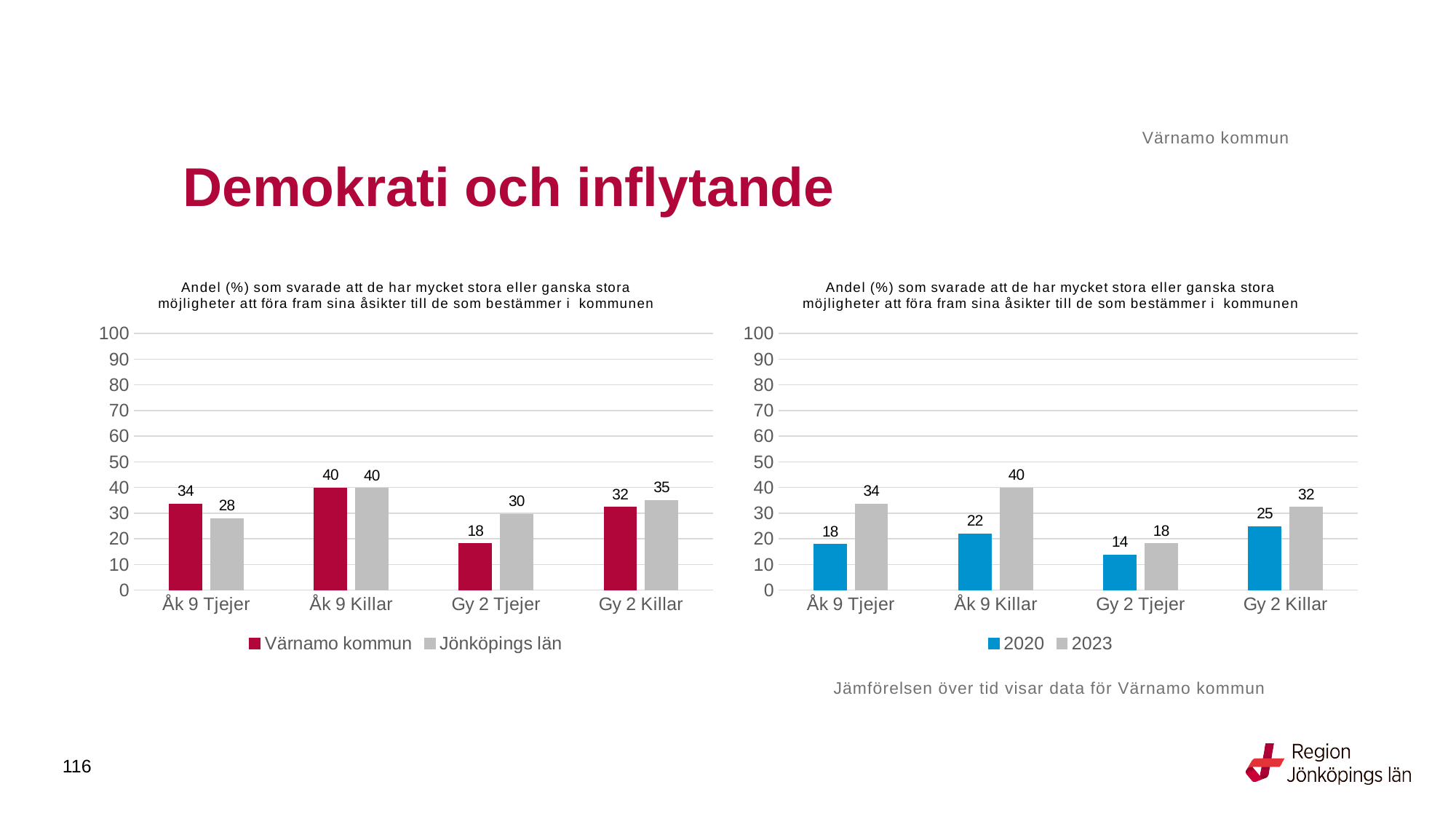
What kind of chart is the right chart? Bar chart In the left chart, which category has the lowest value for Värnamo kommun? Gy 2 Tjejer In the right chart, which category has the highest value for 2023? Åk 9 Killar How many series does the legend of the left chart list? 2 In the right chart, what is the difference between 2023 and 2020 for Åk 9 Killar? 18 In the right chart, what is the value for 2023 for Åk 9 Killar? 40 How many categories are shown on the x axis of the right chart? 4 In the left chart, what is the difference between Värnamo kommun and Jönköpings län for Gy 2 Tjejer? 12 In the left chart, what is the value for Jönköpings län for Gy 2 Tjejer? 30 In the left chart, what is the value for Värnamo kommun for Åk 9 Tjejer? 34 In the left chart, which is larger for Åk 9 Tjejer: Värnamo kommun or Jönköpings län? Värnamo kommun In the right chart, what is the value for 2020 for Gy 2 Killar? 25